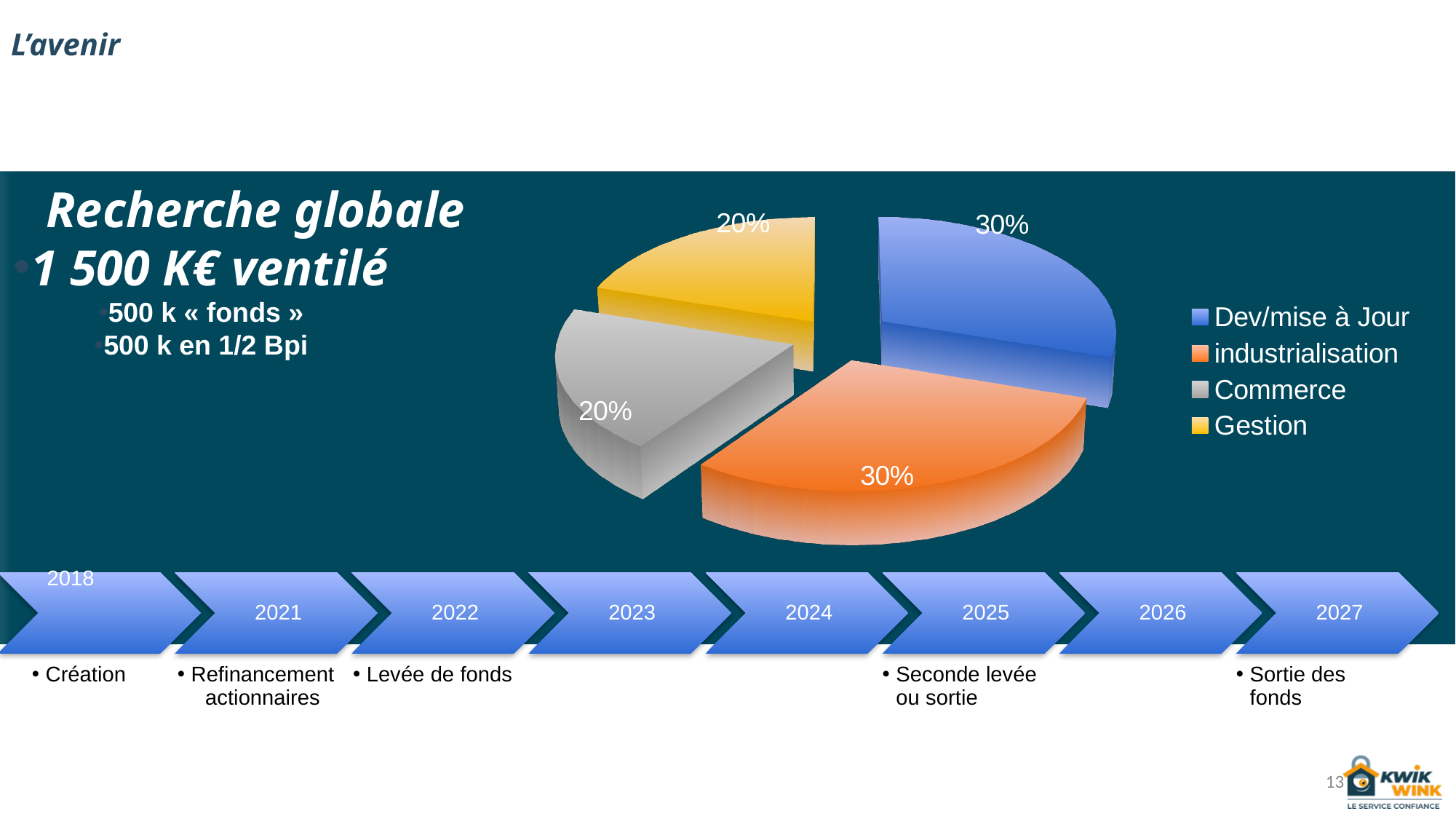
Which is larger, the share for Gestion or the share for industrialisation? industrialisation Which colour represents Commerce in the pie chart? Grey Which is larger, the share for Dev/mise à Jour or the share for Commerce? Dev/mise à Jour Which legend entry is shown in yellow? Gestion How many slices does the pie chart have? 4 What is the difference between the share for industrialisation and the share for Gestion? 10% What kind of chart is shown on the slide? Pie chart What share of the pie does industrialisation represent? 30% What share of the pie does Dev/mise à Jour represent? 30% What share of the pie does Commerce represent? 20% How many entries does the legend list? 4